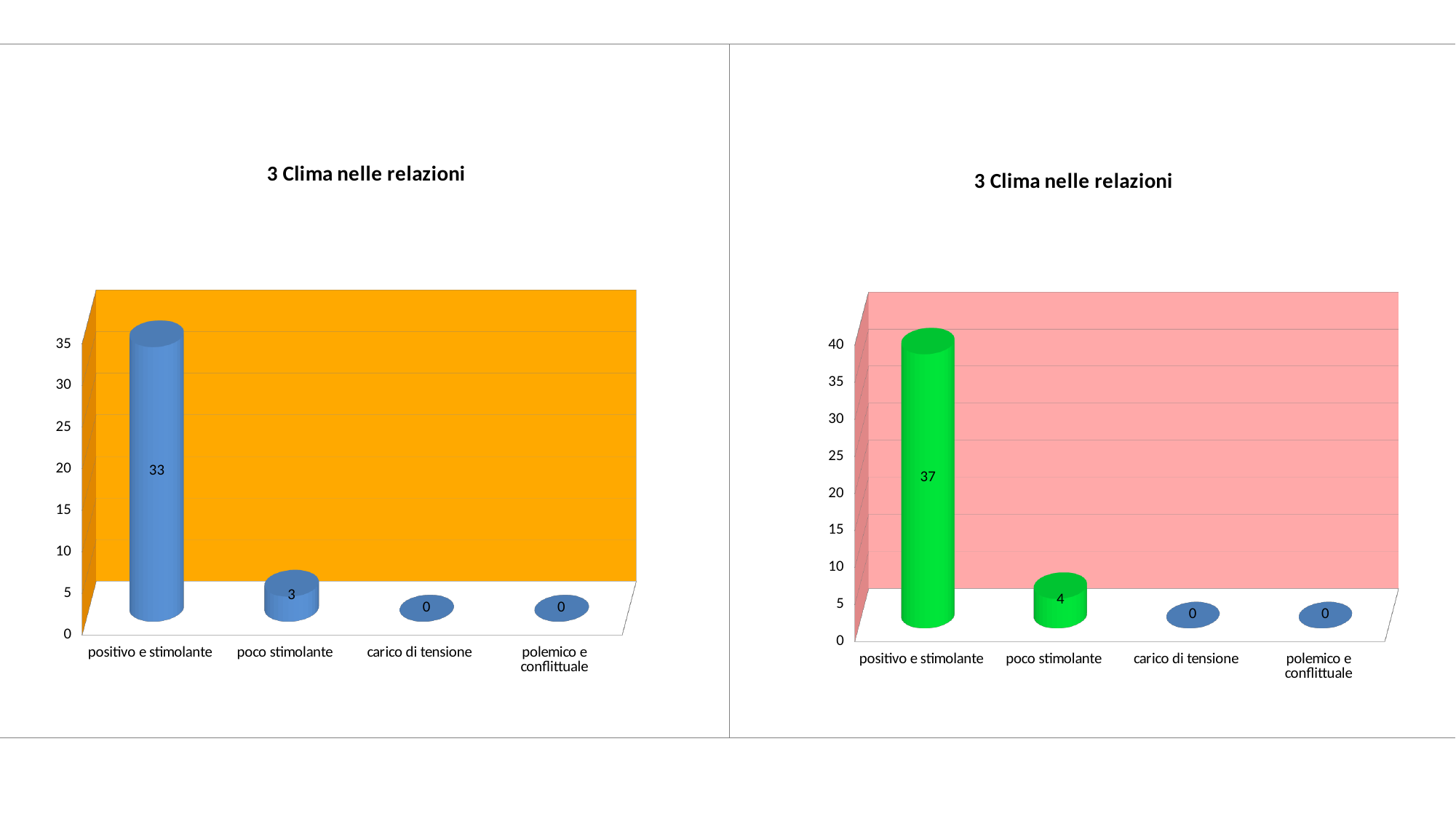
Which chart has the larger value for 'positivo e stimolante', the left chart or the right chart? the right chart How many categories are shown on the x axis of the left chart? 4 In the right chart, what is the value for 'positivo e stimolante'? 37 In the left chart, what is the difference between 'positivo e stimolante' and 'poco stimolante'? 30 In the right chart, what is the value for 'poco stimolante'? 4 In the right chart, which category has the highest value? positivo e stimolante In the left chart, what is the value for 'positivo e stimolante'? 33 In the left chart, what is the value for 'poco stimolante'? 3 In the right chart, what is the value for 'carico di tensione'? 0 In the left chart, which category has the highest value? positivo e stimolante In the right chart, what is the difference between 'positivo e stimolante' and 'poco stimolante'? 33 What type of chart is the right chart? bar chart